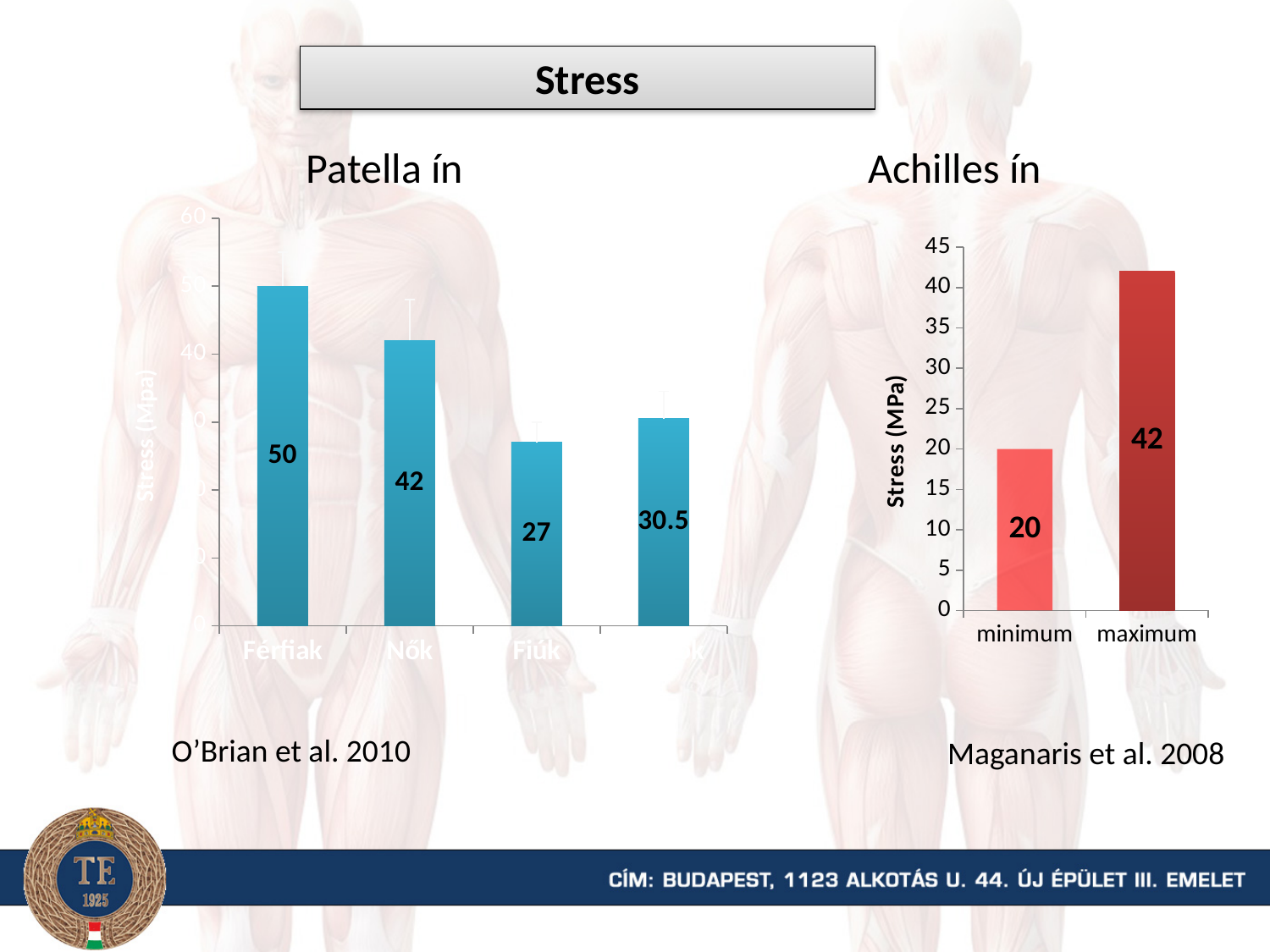
In the Patella ín chart, which category has the lowest stress value? Fiúk In the Patella ín chart, what is the stress value for Fiúk? 27 In the Patella ín chart, what is the difference between the stress values for Férfiak and Nők? 8 In the Achilles ín chart, what is the difference between the maximum and minimum stress values? 22 In the Achilles ín chart, what is the stress value for maximum? 42 In the Achilles ín chart, what is the stress value for minimum? 20 In the Patella ín chart, what is the stress value for Férfiak? 50 Which is larger: the Fiúk value in the Patella ín chart or the minimum value in the Achilles ín chart? Fiúk in the Patella ín chart What type of chart is the Achilles ín chart? Bar chart In the Patella ín chart, how many bars are plotted? 4 In the Patella ín chart, what is the stress value for Nők? 42 In the Patella ín chart, which category has the highest stress value? Férfiak